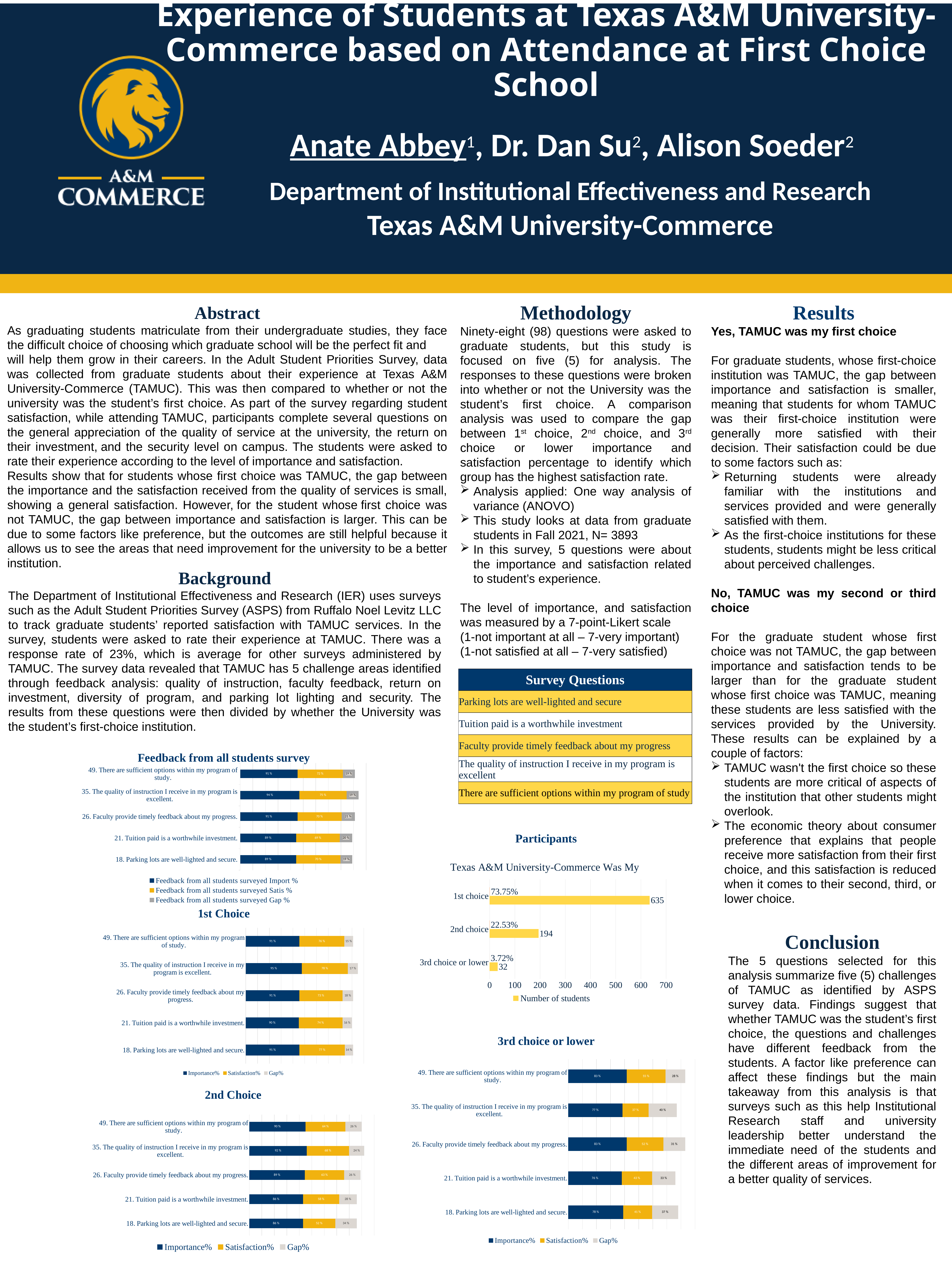
In the Participants chart, which category has the lowest number of students? 3rd choice or lower In the Participants chart, what is the difference in number of students between 1st choice and 2nd choice? 441 In the Participants chart, what percentage of students is shown for 2nd choice? 22.53% In the Participants chart, what percentage of students is shown for 1st choice? 73.75% In the Participants chart, which category has the highest number of students? 1st choice In the Participants chart, what is the legend entry? Number of students In the Participants chart, how many students said Texas A&M University-Commerce was their 2nd choice? 194 In the Participants chart, how many students said Texas A&M University-Commerce was their 3rd choice or lower? 32 What kind of chart is the Participants chart? bar chart In the Participants chart, how many students said Texas A&M University-Commerce was their 1st choice? 635 In the 1st Choice chart, how many series does the legend list? 3 In the Participants chart, how many categories are plotted? 3